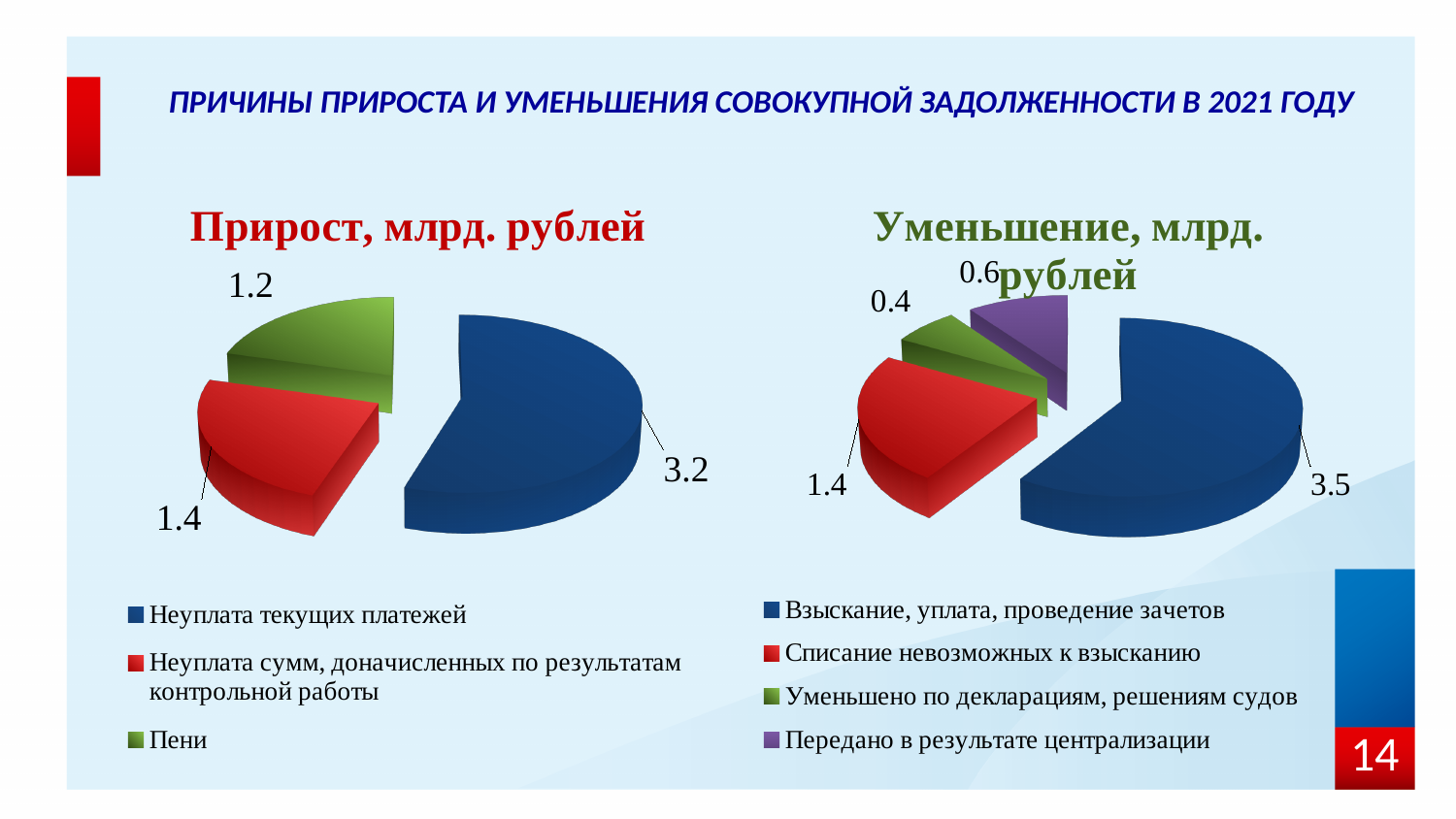
In the chart titled "Прирост, млрд. рублей", what is the value for "Неуплата текущих платежей"? 3.2 In the chart titled "Прирост, млрд. рублей", which colour represents "Пени"? Green In the chart titled "Прирост, млрд. рублей", what is the value for "Пени"? 1.2 In the chart titled "Уменьшение, млрд. рублей", which is larger: "Передано в результате централизации" or "Уменьшено по декларациям, решениям судов"? Передано в результате централизации In the chart titled "Уменьшение, млрд. рублей", what is the value for "Уменьшено по декларациям, решениям судов"? 0.4 In the chart titled "Уменьшение, млрд. рублей", what is the difference between the values for "Взыскание, уплата, проведение зачетов" and "Списание невозможных к взысканию"? 2.1 In the chart titled "Прирост, млрд. рублей", which category has the largest value? Неуплата текущих платежей In the chart titled "Уменьшение, млрд. рублей", which category has the smallest value? Уменьшено по декларациям, решениям судов In the chart titled "Уменьшение, млрд. рублей", what is the value for "Передано в результате централизации"? 0.6 How many categories does the chart titled "Уменьшение, млрд. рублей" show? 4 In the chart titled "Прирост, млрд. рублей", what is the difference between the values for "Неуплата текущих платежей" and "Пени"? 2.0 What kind of chart is the chart titled "Прирост, млрд. рублей"? Pie chart